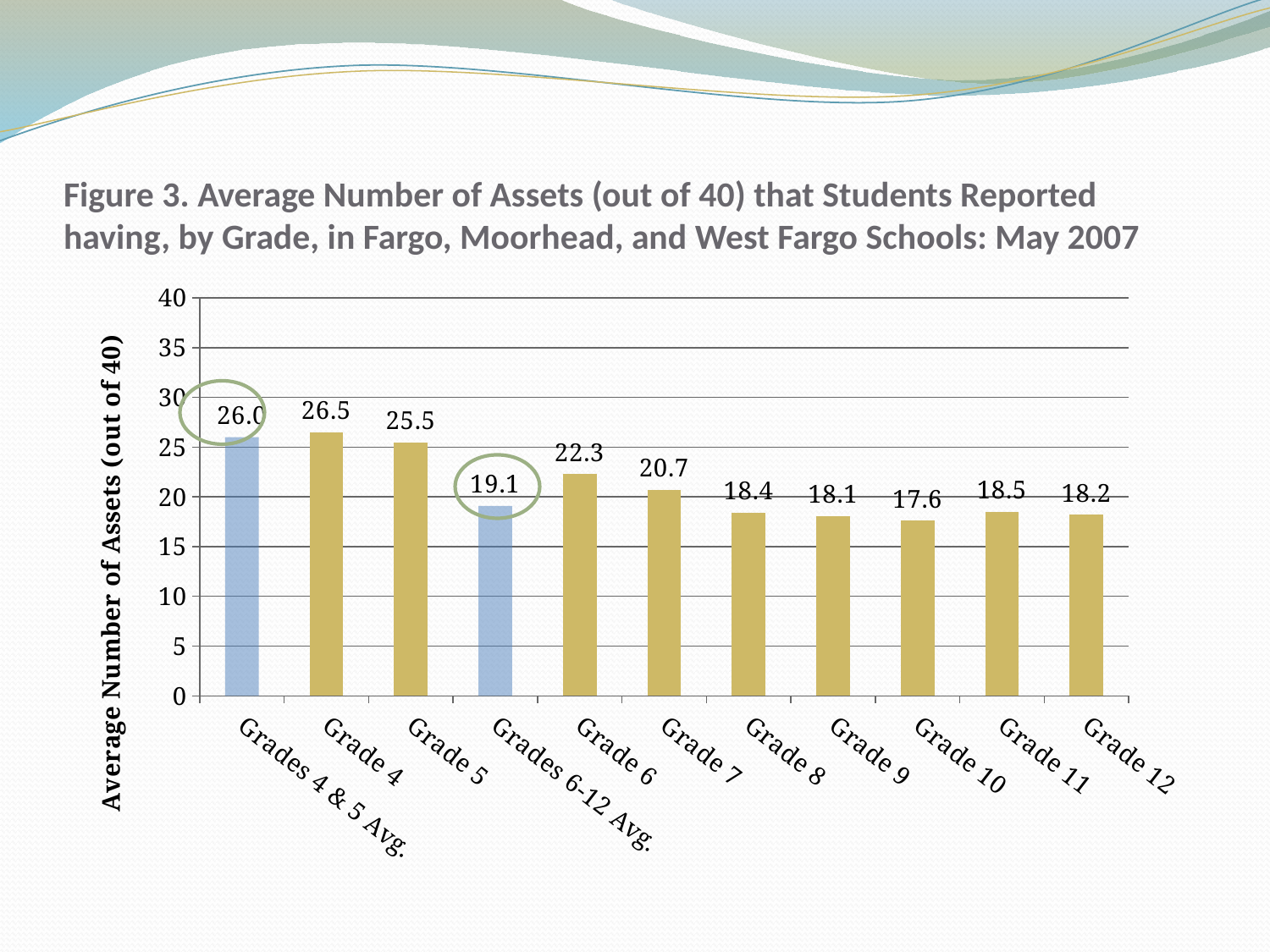
What is the value shown for Grades 6-12 Avg.? 19.1 Which grade has the lowest average number of assets? Grade 10 What is the average number of assets for Grade 10? 17.6 What is the difference between the Grades 4 & 5 Avg. and the Grades 6-12 Avg.? 6.9 Which is larger, the value for Grade 5 or the value for Grade 6? Grade 5 What is the average number of assets for Grade 4? 26.5 Is the value for Grade 8 greater or less than 20? less What kind of chart is shown on the slide? bar chart What is the difference between Grade 6 and Grade 7? 1.6 How many bars are shown in the chart? 11 What is the label of the vertical axis? Average Number of Assets (out of 40) Which grade has the highest average number of assets? Grade 4